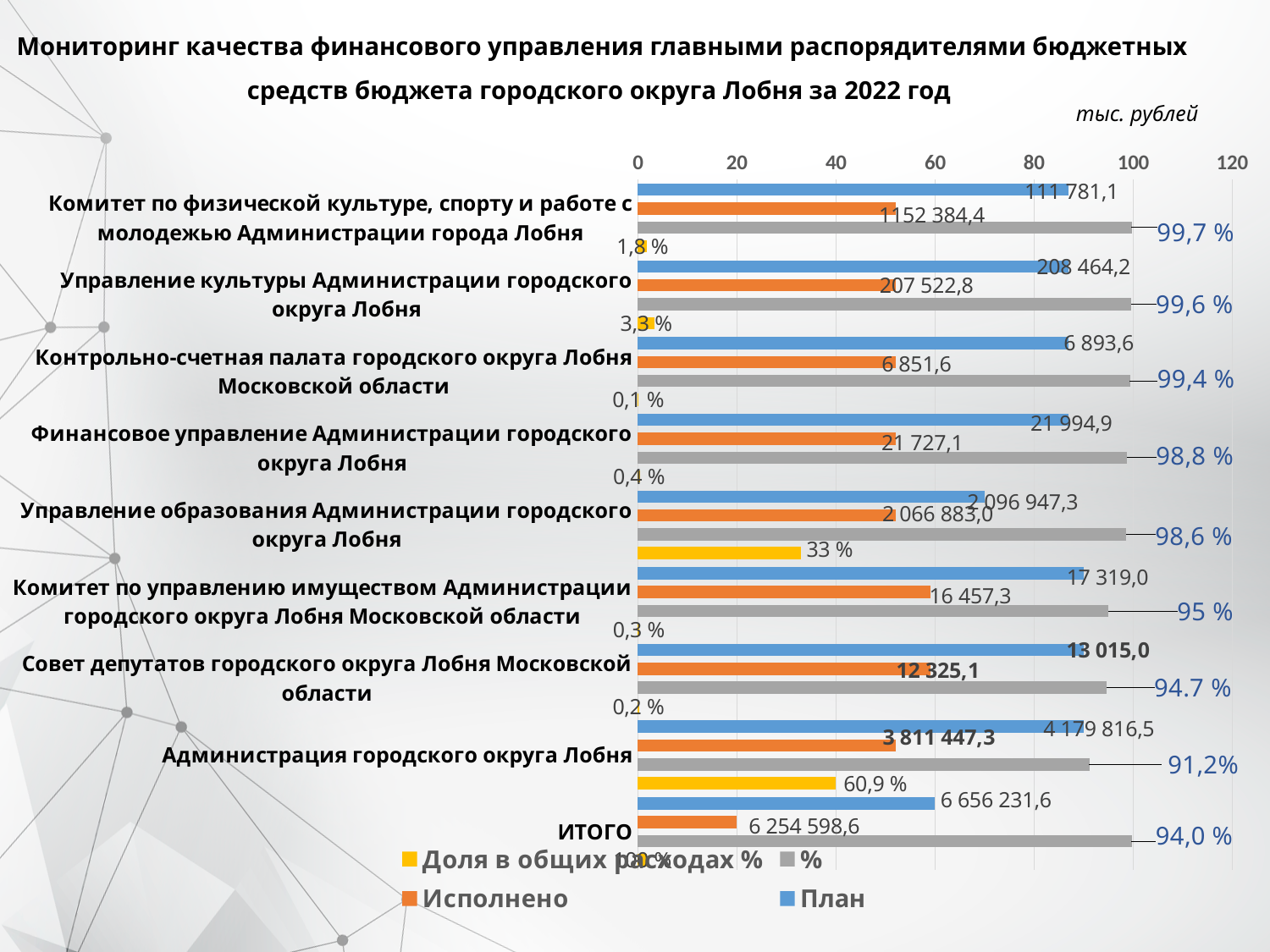
What type of chart is shown on the slide? Bar chart What is the Исполнено value for Финансовое управление Администрации городского округа Лобня? 21 727,1 What is the value of the План series for Управление культуры Администрации городского округа Лобня? 208 464,2 What is the difference between План and Исполнено for Контрольно-счетная палата городского округа Лобня Московской области? 42,0 How many series does the legend list? 4 What percentage (% series) is shown for Совет депутатов городского округа Лобня Московской области? 94.7 % Which category has the lowest value in the % series? Администрация городского округа Лобня Is the Доля в общих расходах % bar for Управление образования Администрации городского округа Лобня greater or less than 40? less Which has the larger План value: Совет депутатов городского округа Лобня Московской области or Комитет по управлению имуществом Администрации городского округа Лобня Московской области? Комитет по управлению имуществом Администрации городского округа Лобня Московской области What is the Доля в общих расходах % value for Администрация городского округа Лобня? 60,9 % Which category has the highest value in the % series? Комитет по физической культуре, спорту и работе с молодежью Администрации города Лобня What is the Исполнено value for the ИТОГО row? 6 254 598,6